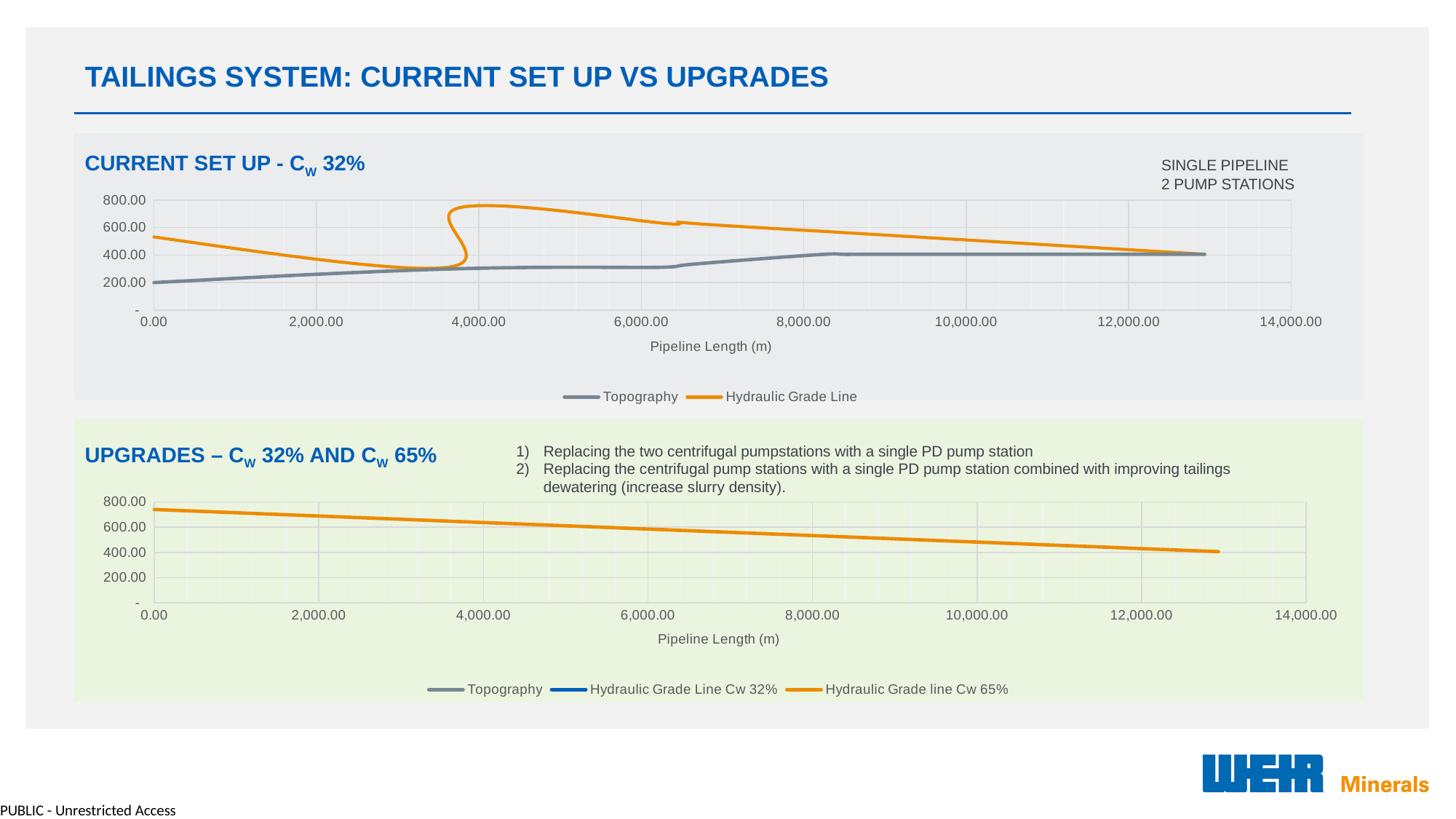
In the 'CURRENT SET UP - Cw 32%' chart, is the Topography value at pipeline length 0.00 greater or less than 400.00? less In the 'CURRENT SET UP - Cw 32%' chart, which series is drawn in orange? Hydraulic Grade Line How many series does the legend of the 'UPGRADES – Cw 32% AND Cw 65%' chart list? 3 In the 'CURRENT SET UP - Cw 32%' chart, at pipeline length 0.00, which is larger: the Hydraulic Grade Line or the Topography? Hydraulic Grade Line How many series does the legend of the 'CURRENT SET UP - Cw 32%' chart list? 2 In the 'CURRENT SET UP - Cw 32%' chart, does the Topography line generally rise or fall along the x axis? rise In the 'CURRENT SET UP - Cw 32%' chart, is the peak of the Hydraulic Grade Line near 4,000.00 m greater or less than 600.00? greater What kind of chart is the 'CURRENT SET UP - Cw 32%' chart? line chart In the 'UPGRADES – Cw 32% AND Cw 65%' chart, is the Hydraulic Grade line Cw 65% value at pipeline length 0.00 greater or less than 600.00? greater In the 'CURRENT SET UP - Cw 32%' chart, what is the x-axis title? Pipeline Length (m) In the 'UPGRADES – Cw 32% AND Cw 65%' chart, does the Hydraulic Grade line Cw 65% rise or fall along the x axis? fall